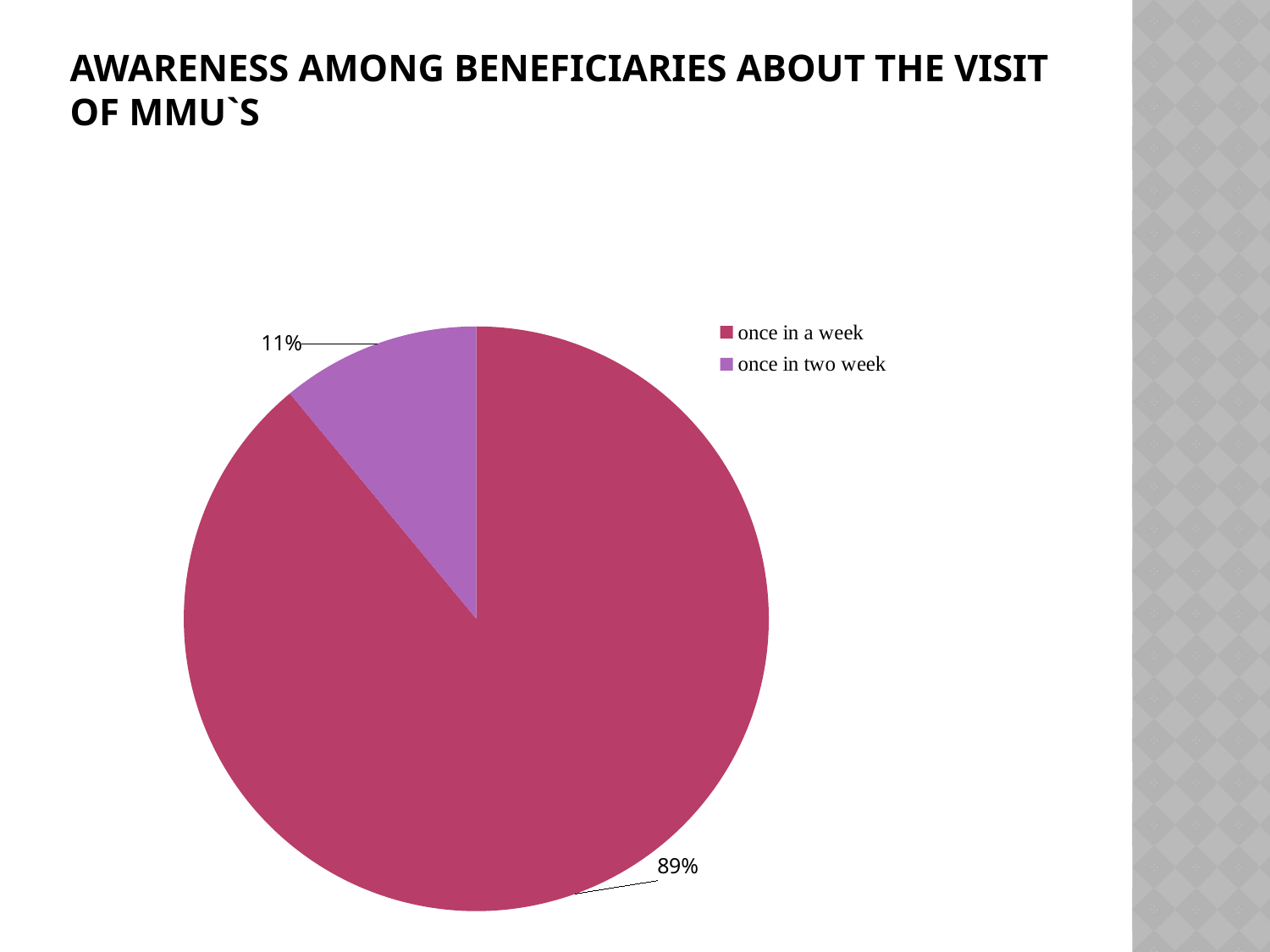
What kind of chart is shown on the slide? pie chart What is the title of the slide containing the pie chart? AWARENESS AMONG BENEFICIARIES ABOUT THE VISIT OF MMU`S What share of the pie does "once in two week" represent? 11% Which category is shown in the purple colour in the pie chart? once in two week How many categories does the pie chart show? 2 What share of the pie does "once in a week" represent? 89% Which is larger: the slice for "once in a week" or the slice for "once in two week"? once in a week How many entries does the legend list? 2 What is the difference in percentage points between the "once in a week" and "once in two week" slices? 78 Which category has the smallest slice of the pie? once in two week Which category has the largest slice of the pie? once in a week